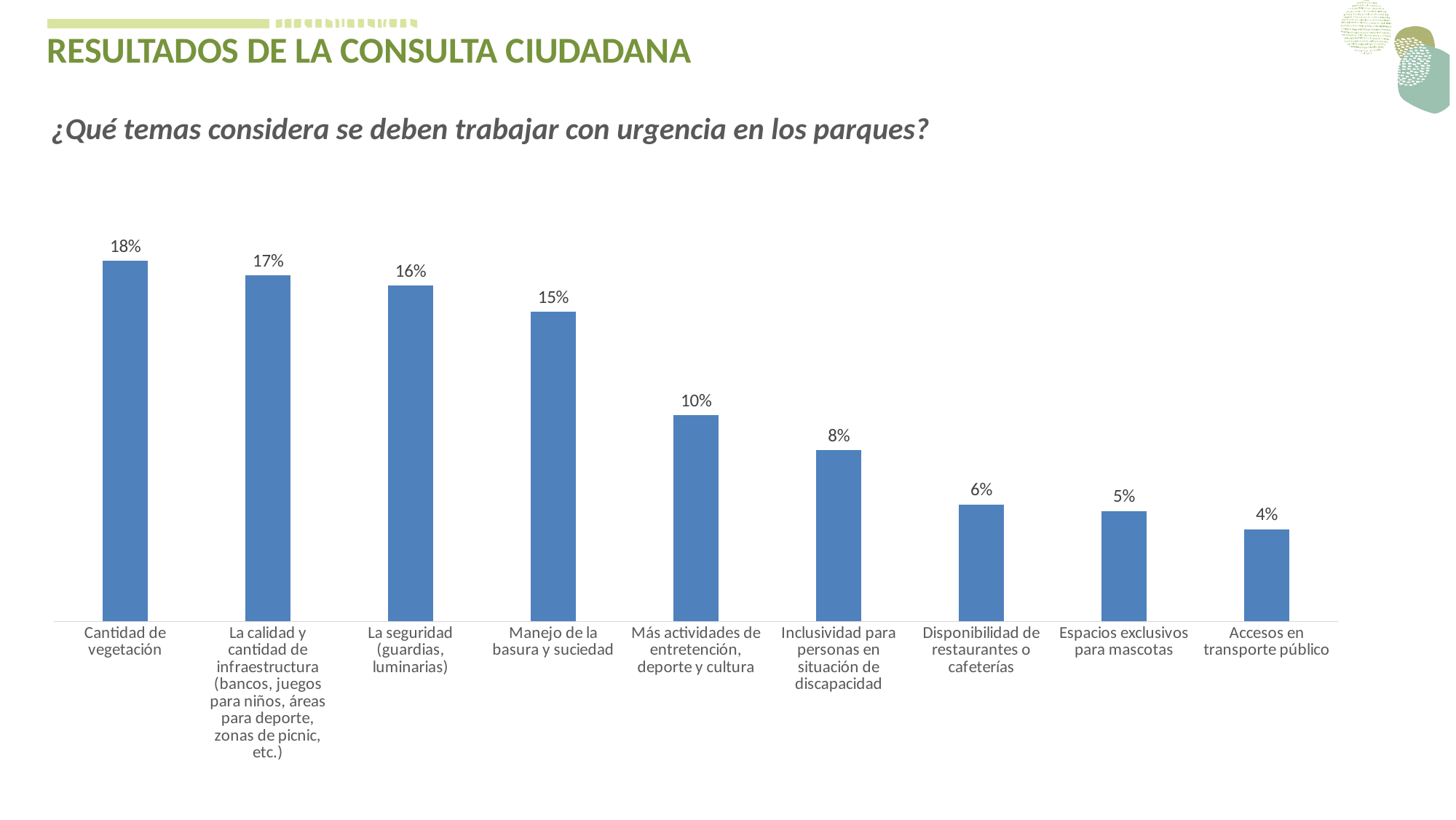
Which category has the lowest value? Accesos en transporte público What kind of chart is shown on the slide? Bar chart What is the difference between the highest and lowest values in the chart? 14% Which is larger: the value for "Inclusividad para personas en situación de discapacidad" or for "Disponibilidad de restaurantes o cafeterías"? Inclusividad para personas en situación de discapacidad What question does the chart answer, as written above it? ¿Qué temas considera se deben trabajar con urgencia en los parques? What is the value for "Manejo de la basura y suciedad"? 15% How many categories are shown in the chart? 9 What percentage is shown for "Espacios exclusivos para mascotas"? 5% Which category has the highest value? Cantidad de vegetación What percentage is shown for "Cantidad de vegetación"? 18% What is the difference between the values for "La seguridad (guardias, luminarias)" and "Más actividades de entretención, deporte y cultura"? 6% Do the values rise or fall from left to right along the x axis? Fall